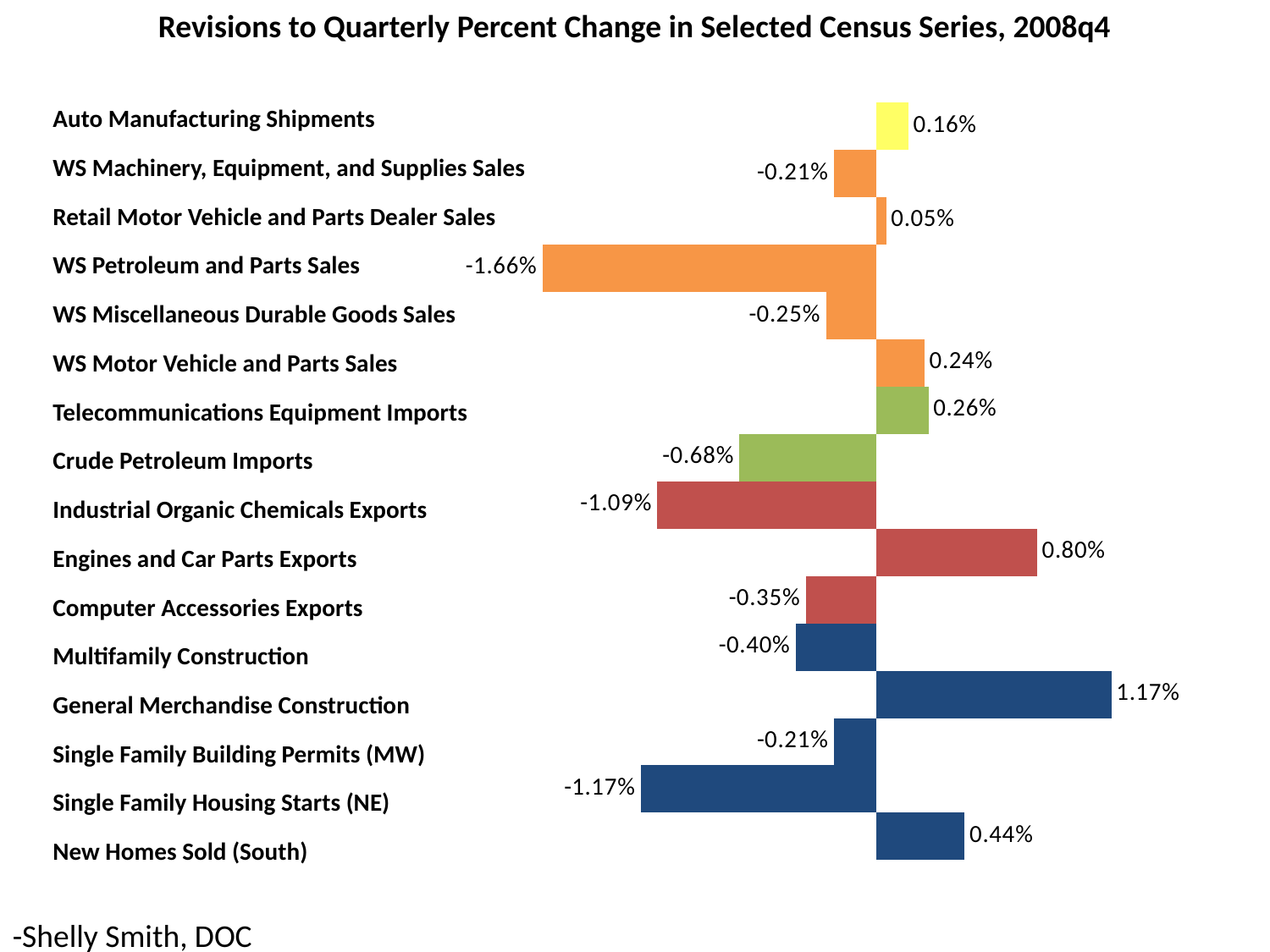
What is the value for New Homes Sold (South)? 0.44% Which is larger, the value for Engines and Car Parts Exports or the value for New Homes Sold (South)? Engines and Car Parts Exports What is the value for General Merchandise Construction? 1.17% Which series has the highest (most positive) revision? General Merchandise Construction Which series has the lowest (most negative) revision? WS Petroleum and Parts Sales What is the value for WS Petroleum and Parts Sales? -1.66% What is the difference between the values for General Merchandise Construction and Engines and Car Parts Exports? 0.37 percentage points How many series (categories) are plotted on the chart? 16 What is the title of the chart? Revisions to Quarterly Percent Change in Selected Census Series, 2008q4 What is the difference between the values for New Homes Sold (South) and Telecommunications Equipment Imports? 0.18 percentage points What kind of chart is shown on the slide? Bar chart What is the value for Crude Petroleum Imports? -0.68%